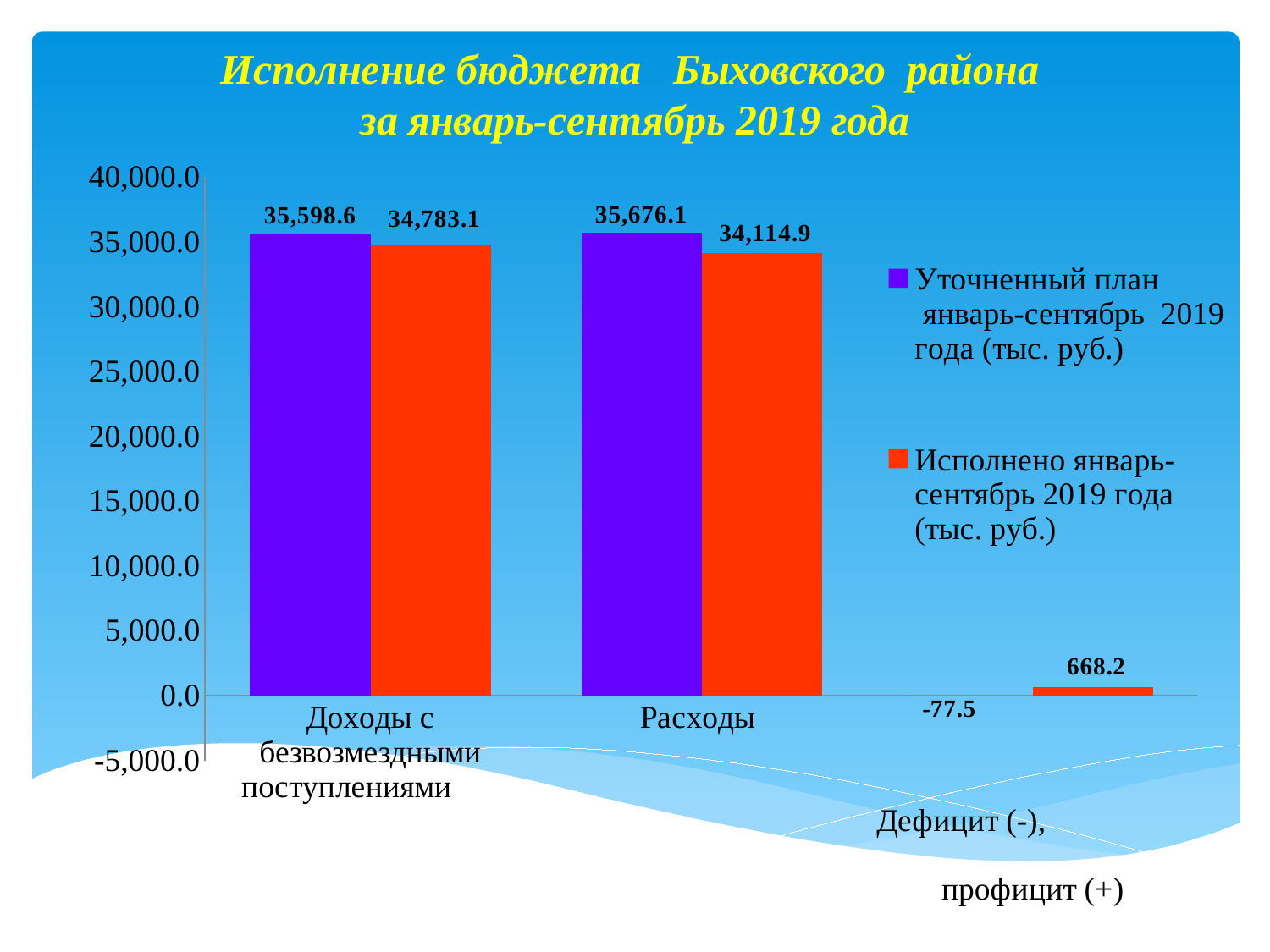
Which category has the lowest value in the 'Исполнено январь-сентябрь 2019 года (тыс. руб.)' series? Дефицит (-), профицит (+) What type of chart is shown on the slide? Bar chart What is the value of 'Уточненный план январь-сентябрь 2019 года (тыс. руб.)' for 'Дефицит (-), профицит (+)'? -77.5 What is the value of 'Исполнено январь-сентябрь 2019 года (тыс. руб.)' for 'Расходы'? 34,114.9 For 'Доходы с безвозмездными поступлениями', which is larger: the planned value or the executed value? Уточненный план январь-сентябрь 2019 года (тыс. руб.) Which category has the highest value in the 'Уточненный план январь-сентябрь 2019 года (тыс. руб.)' series? Расходы What is the difference between the planned and executed values for 'Расходы'? 1,561.2 What is the value of 'Уточненный план январь-сентябрь 2019 года (тыс. руб.)' for 'Доходы с безвозмездными поступлениями'? 35,598.6 What is the value of 'Исполнено январь-сентябрь 2019 года (тыс. руб.)' for 'Дефицит (-), профицит (+)'? 668.2 How many series does the legend list? 2 How many categories are shown on the x axis? 3 What is the difference between the planned and executed values for 'Доходы с безвозмездными поступлениями'? 815.5